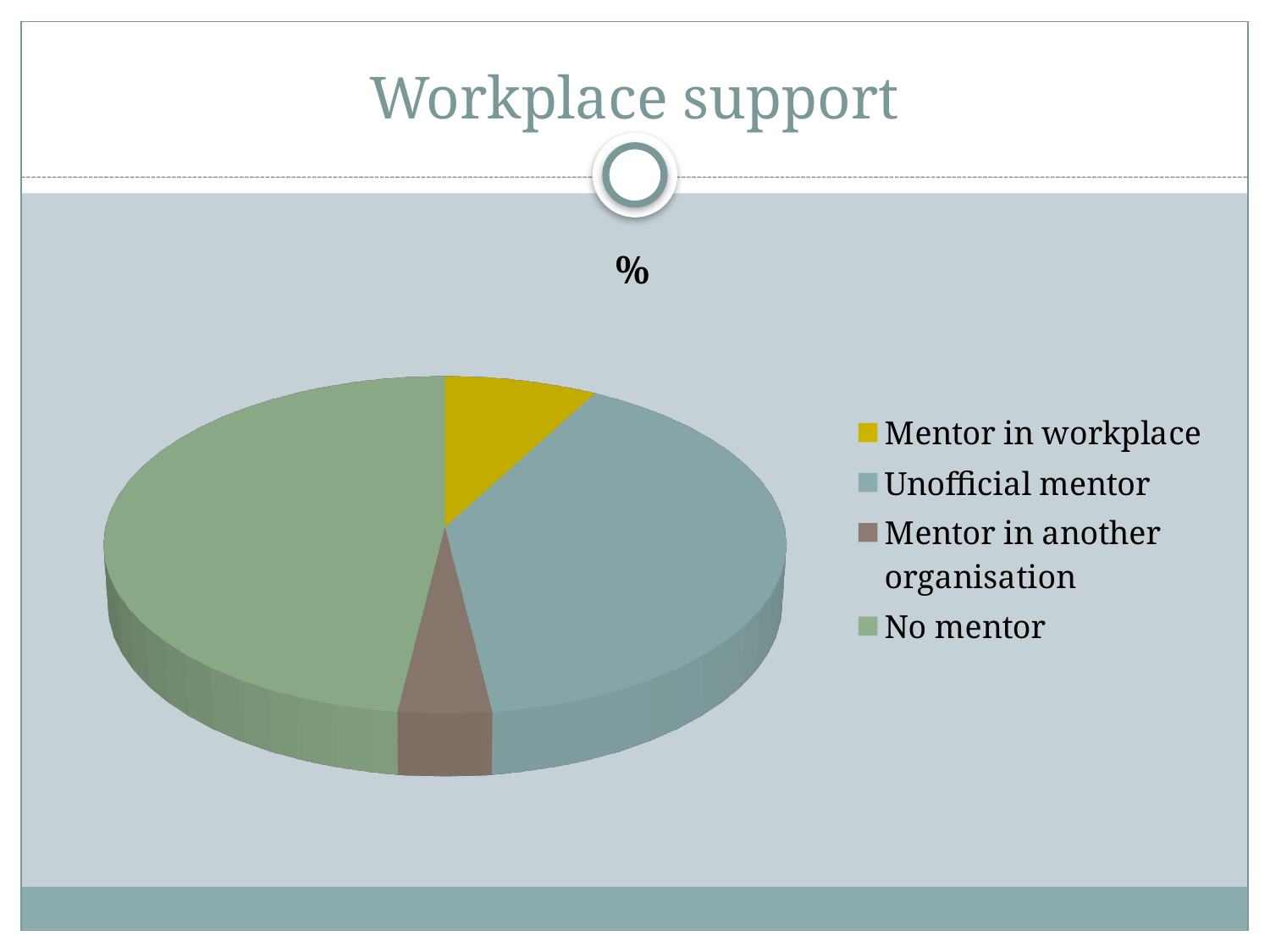
What kind of chart is shown on the slide? pie chart Which category has the smallest slice of the pie? Mentor in another organisation Which category has the largest slice of the pie? No mentor Which slice is larger: No mentor or Unofficial mentor? No mentor What is the title shown above the pie chart? % Which category is shown in yellow in the legend? Mentor in workplace Which slice is larger: Mentor in workplace or Mentor in another organisation? Mentor in workplace Which slice is larger: Unofficial mentor or Mentor in workplace? Unofficial mentor How many categories (slices) does the pie chart have? 4